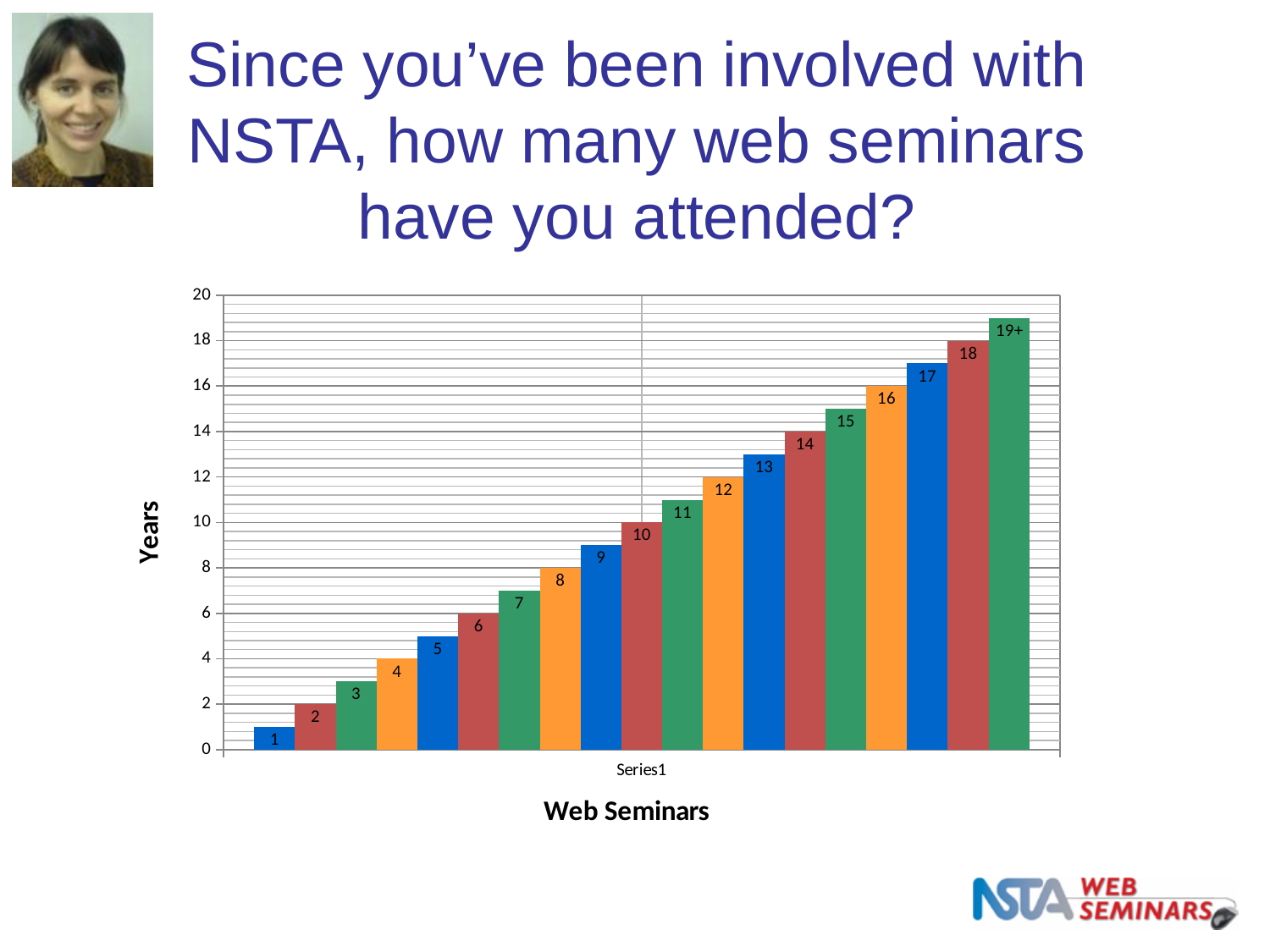
What kind of chart is shown on the slide? bar chart What is the highest value shown on the vertical axis? 20 What is the title of the vertical axis? Years How many bars are plotted in the chart? 19 What is the difference between the bar labeled 18 and the bar labeled 10? 8 Is the value of the bar labeled 5 greater or less than 6? less Is the value of the bar labeled 12 greater or less than 10? greater Which is taller, the bar labeled 7 or the bar labeled 14? 14 What is the data label on the shortest bar in the chart? 1 Do the bar values rise or fall from left to right across the chart? rise What is the title of the horizontal axis? Web Seminars What is the data label on the tallest bar in the chart? 19+